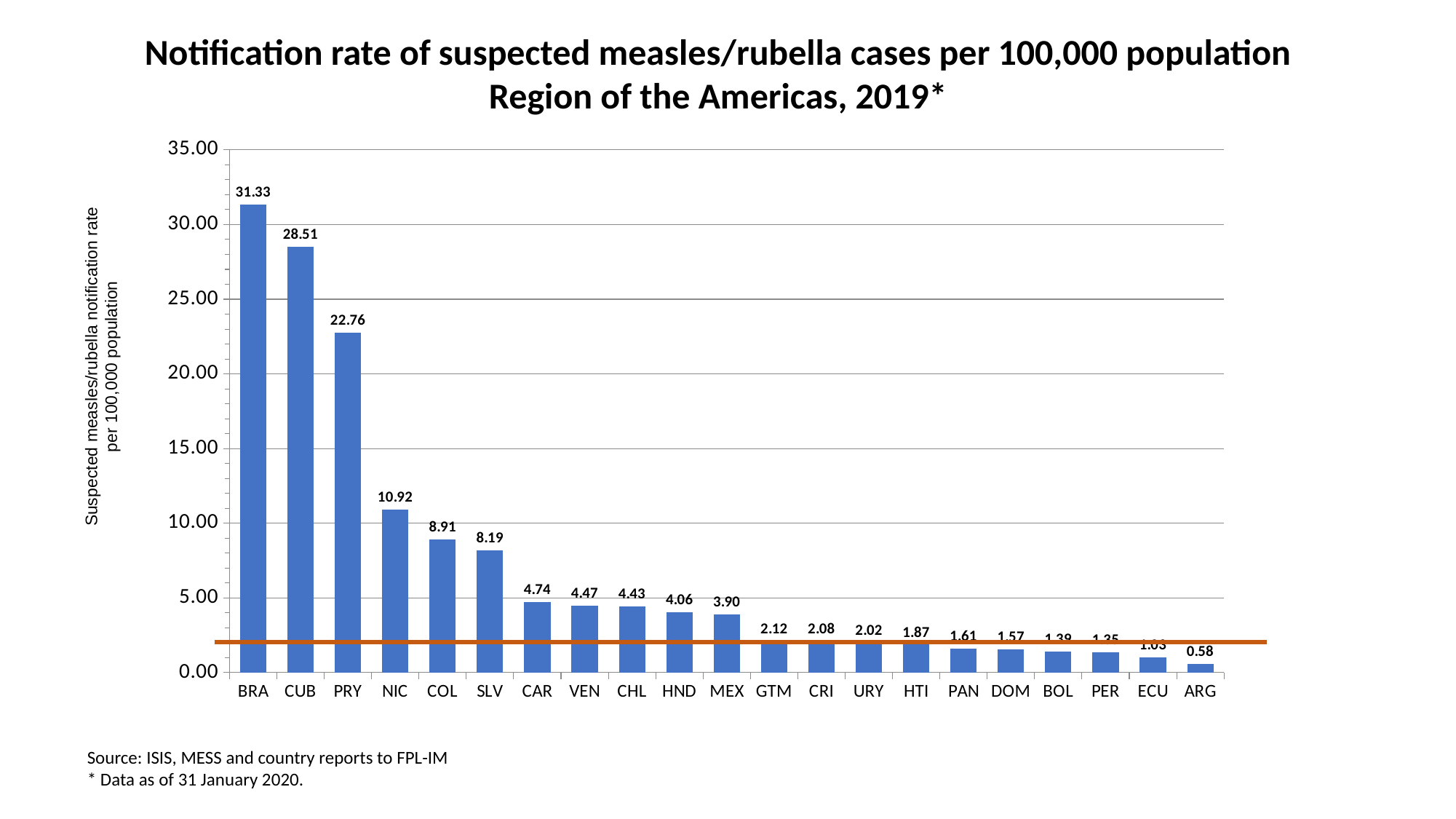
How many countries are shown on the x axis? 21 What is the difference between the notification rates of PRY and NIC? 11.84 What kind of chart is this? Bar chart Which country has the lowest notification rate? ARG What is the notification rate for BRA? 31.33 What is the difference between the notification rates of BRA and CUB? 2.82 Is the value for PRY greater or less than 20.00? greater Which country has the highest notification rate? BRA What is the notification rate for MEX? 3.90 Which has a higher notification rate, COL or SLV? COL What is the notification rate for NIC? 10.92 What is the notification rate for ARG? 0.58